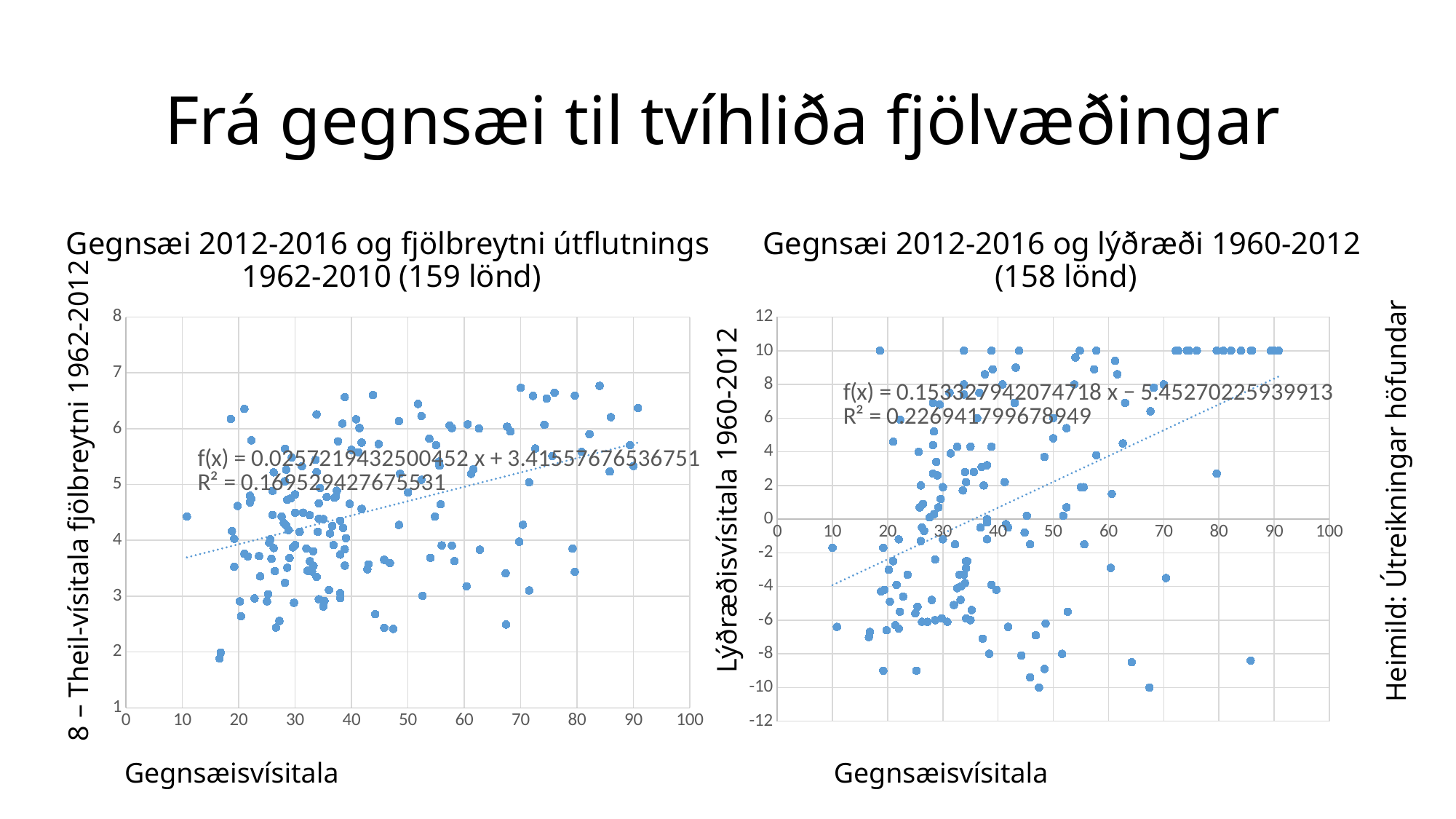
In the right chart, 'Gegnsæi 2012-2016 og lýðræði 1960-2012', what is the R² value shown? 0.226941799678949 In the right chart, 'Gegnsæi 2012-2016 og lýðræði 1960-2012', how many countries are plotted according to the title? 158 What kind of chart is the right chart, 'Gegnsæi 2012-2016 og lýðræði 1960-2012 (158 lönd)'? Scatter chart What is the x-axis label of the left chart, 'Gegnsæi 2012-2016 og fjölbreytni útflutnings 1962-2010'? Gegnsæisvísitala In the left chart, 'Gegnsæi 2012-2016 og fjölbreytni útflutnings 1962-2010', what is the R² value shown? 0.169529427675531 In the left chart, 'Gegnsæi 2012-2016 og fjölbreytni útflutnings 1962-2010', does the fitted trend line rise or fall as the x value increases? Rise What kind of chart is the left chart, 'Gegnsæi 2012-2016 og fjölbreytni útflutnings 1962-2010 (159 lönd)'? Scatter chart In the left chart, 'Gegnsæi 2012-2016 og fjölbreytni útflutnings 1962-2010', how many countries are plotted according to the title? 159 In the left chart, 'Gegnsæi 2012-2016 og fjölbreytni útflutnings 1962-2010', what is the constant term in the fitted equation f(x)? 3.41557676536751 In the right chart, 'Gegnsæi 2012-2016 og lýðræði 1960-2012', what is the slope coefficient of x in the fitted equation? 0.153327942074718 Which chart shows the higher R² value, the left chart or the right chart? The right chart (Gegnsæi 2012-2016 og lýðræði 1960-2012) In the right chart, 'Gegnsæi 2012-2016 og lýðræði 1960-2012', does the fitted trend line rise or fall as the x value increases? Rise